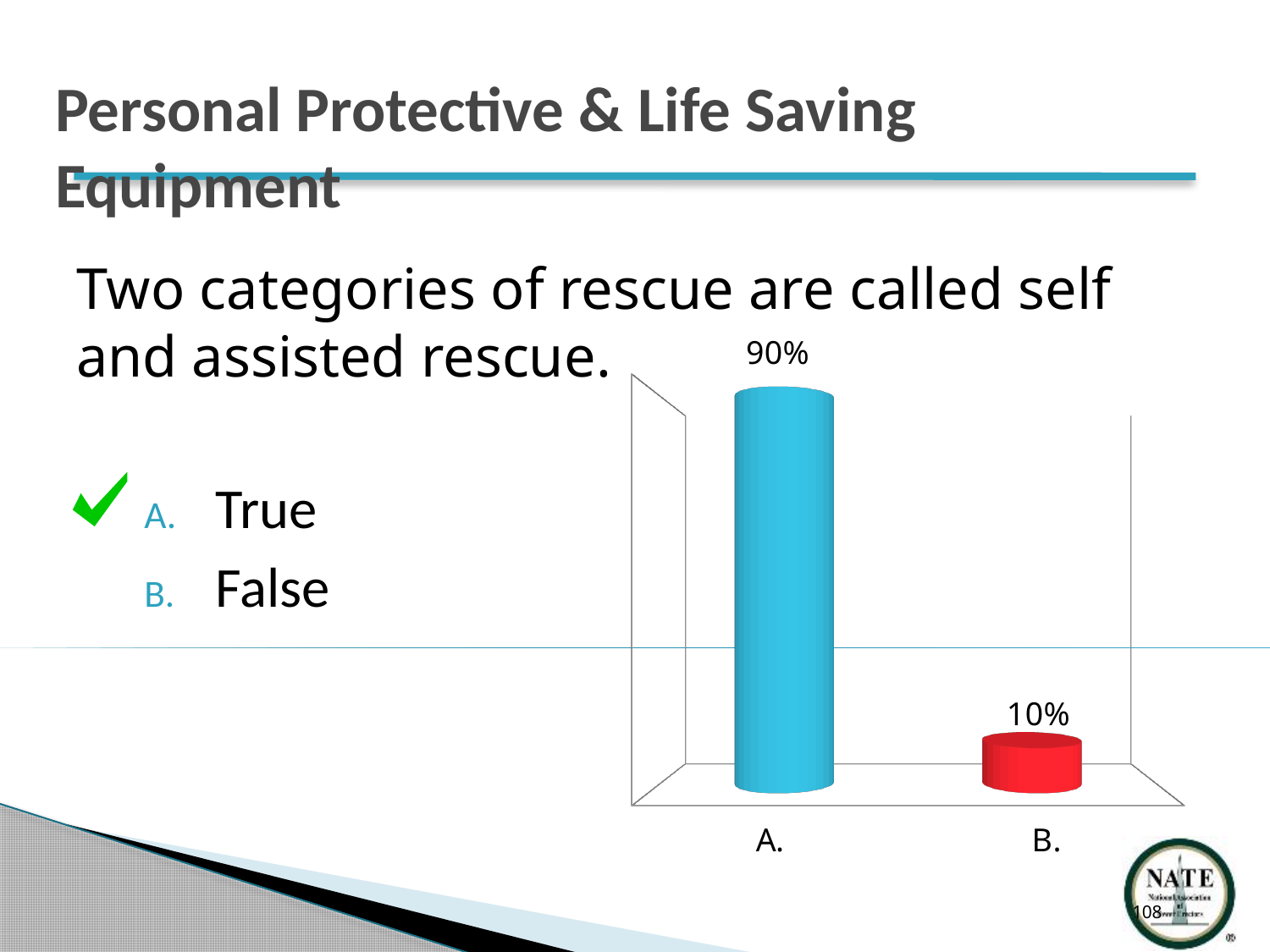
What is the value for category B. in the chart? 10% What kind of chart is shown on the slide? Bar chart How many categories are shown in the chart? 2 What is the value for category A. in the chart? 90% Which is larger, the value for A. or the value for B.? A. What is the difference between the values for A. and B.? 80% Which category has the highest value in the chart? A. What is the total of the values for A. and B.? 100% What colour is the bar for category A.? Blue Do the values rise or fall from A. to B. along the x axis? Fall What colour is the bar for category B.? Red Which category has the lowest value in the chart? B.